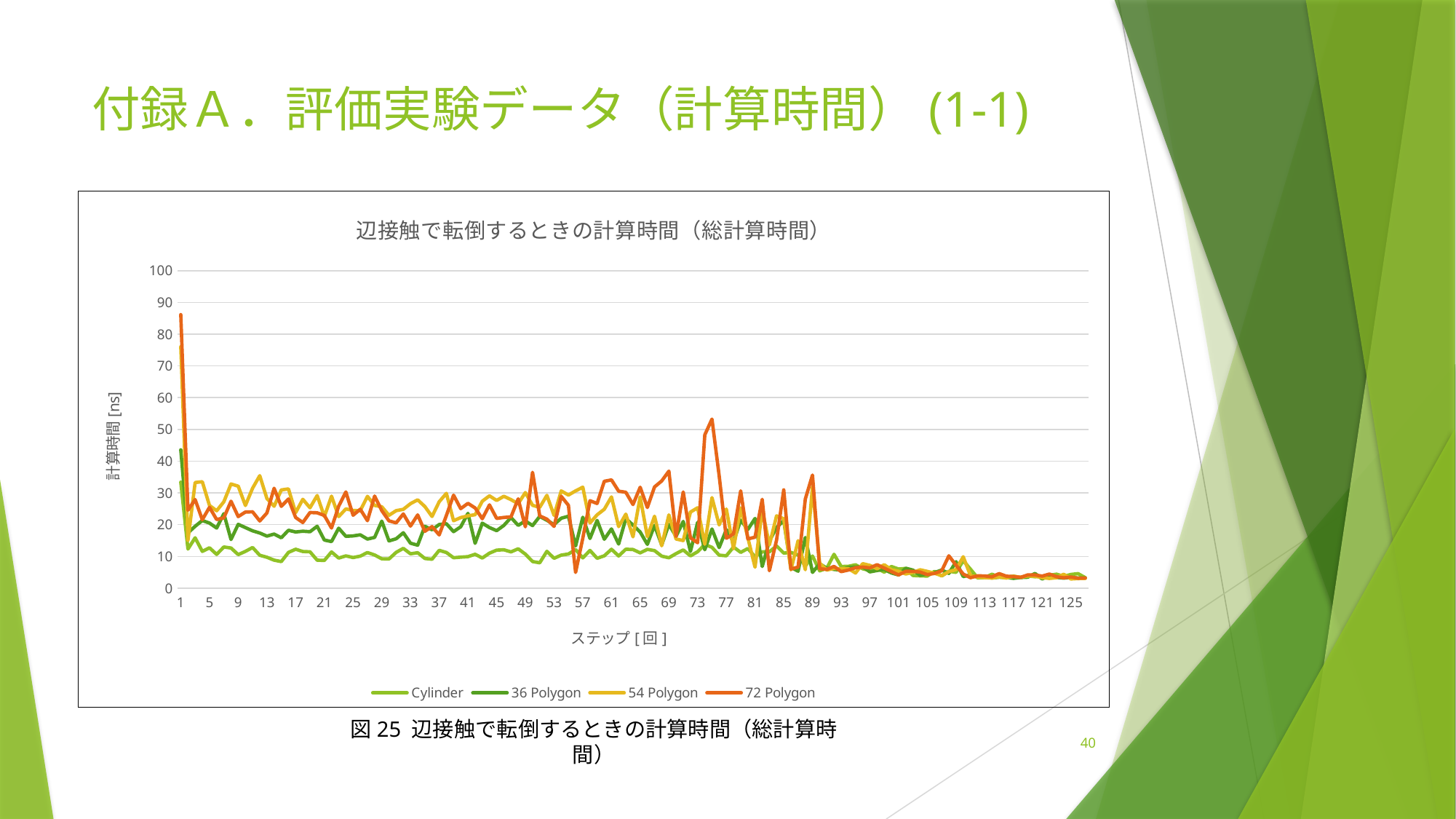
Is the value for Cylinder at step 125 greater or less than 10? less What is the title of the chart? 辺接触で転倒するときの計算時間（総計算時間） Which series has the highest value at step 1? 72 Polygon Is the value for 72 Polygon at step 1 greater or less than 80? greater How many series does the legend list? 4 At step 1, which is larger: the value for 36 Polygon or the value for Cylinder? 36 Polygon What kind of chart is shown on the slide? line chart What is the highest value shown on the y axis? 100 Do the values generally rise or fall as the step number increases along the x axis? fall Is the value for 72 Polygon at step 75 greater or less than 40? greater What are the series names listed in the legend? Cylinder, 36 Polygon, 54 Polygon, 72 Polygon